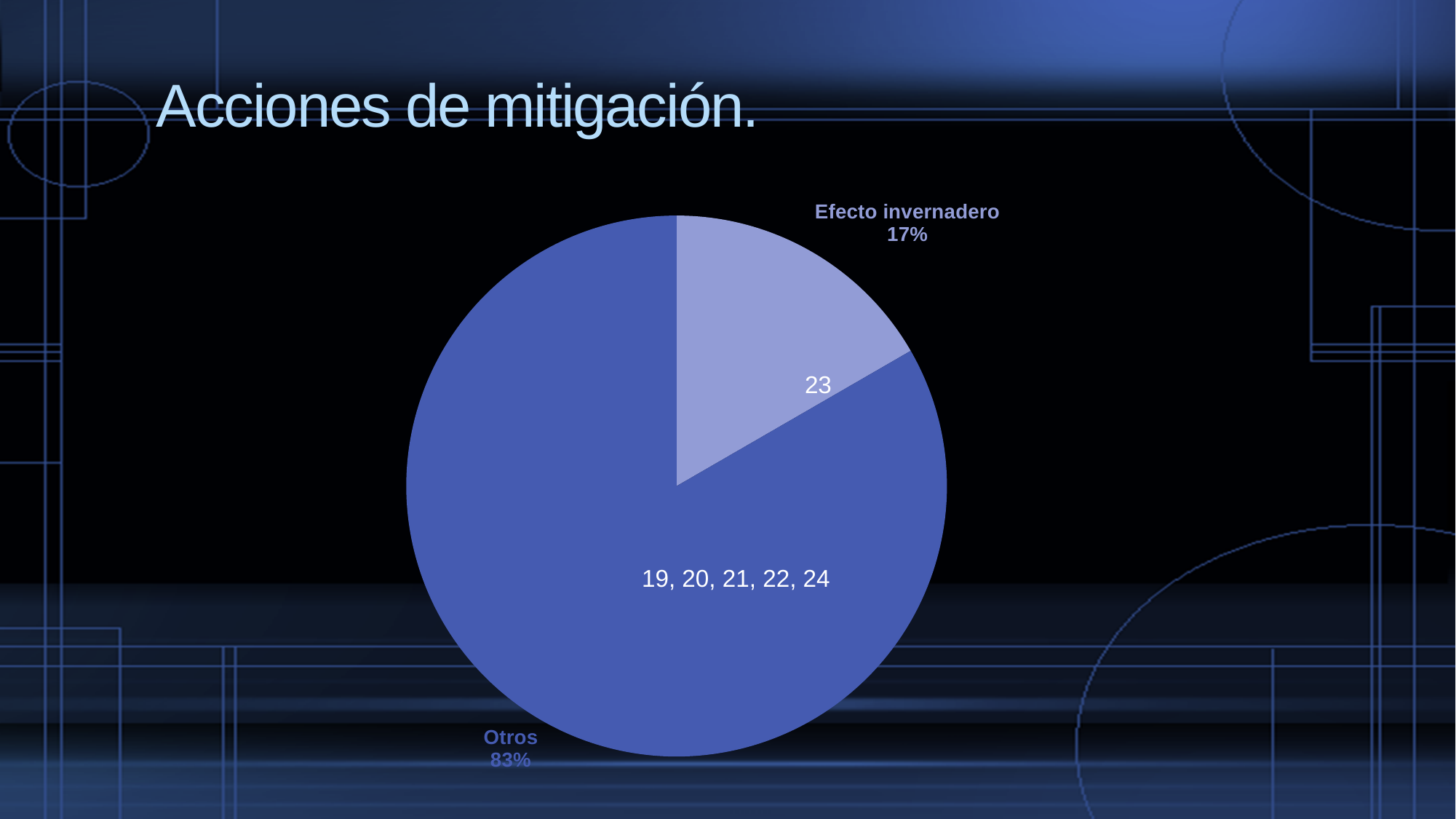
Which slice is larger, "Otros" or "Efecto invernadero"? Otros Which slice of the pie chart is the largest? Otros Which slice of the pie chart is the smallest? Efecto invernadero What is the difference in percentage points between the "Otros" slice and the "Efecto invernadero" slice? 66 What share of the pie does the "Efecto invernadero" slice represent? 17% What number is written inside the "Efecto invernadero" slice? 23 What share of the pie does the "Otros" slice represent? 83% What is the title of the slide containing the pie chart? Acciones de mitigación. What numbers are written inside the "Otros" slice? 19, 20, 21, 22, 24 Is the share of the "Efecto invernadero" slice greater or less than 20%? less What kind of chart is shown on the slide? pie chart How many slices does the pie chart have? 2